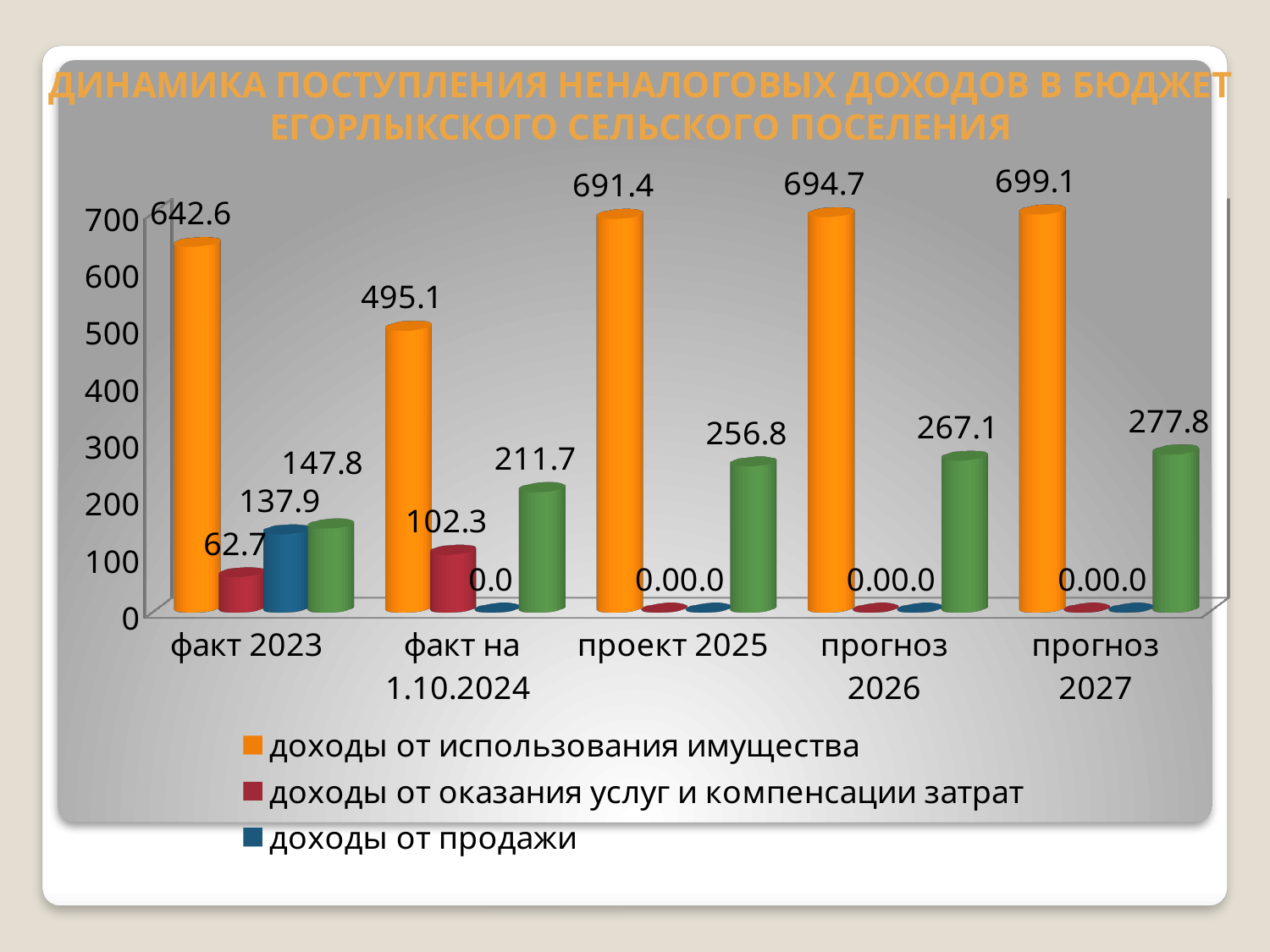
Which is larger for доходы от оказания услуг и компенсации затрат: факт 2023 or факт на 1.10.2024? факт на 1.10.2024 What is the value of доходы от использования имущества for факт 2023? 642.6 How many categories are shown on the x axis? 5 What is the value of доходы от использования имущества for прогноз 2027? 699.1 What is the value of доходы от оказания услуг и компенсации затрат for факт на 1.10.2024? 102.3 What is the difference between доходы от использования имущества for проект 2025 and for факт 2023? 48.8 Which category has the lowest value for доходы от использования имущества? факт на 1.10.2024 What kind of chart is shown on the slide? bar chart How many series does the legend list? 3 Do the values for доходы от использования имущества rise or fall from проект 2025 to прогноз 2027? rise What is the value of доходы от продажи for факт 2023? 137.9 Which category has the highest value for доходы от использования имущества? прогноз 2027